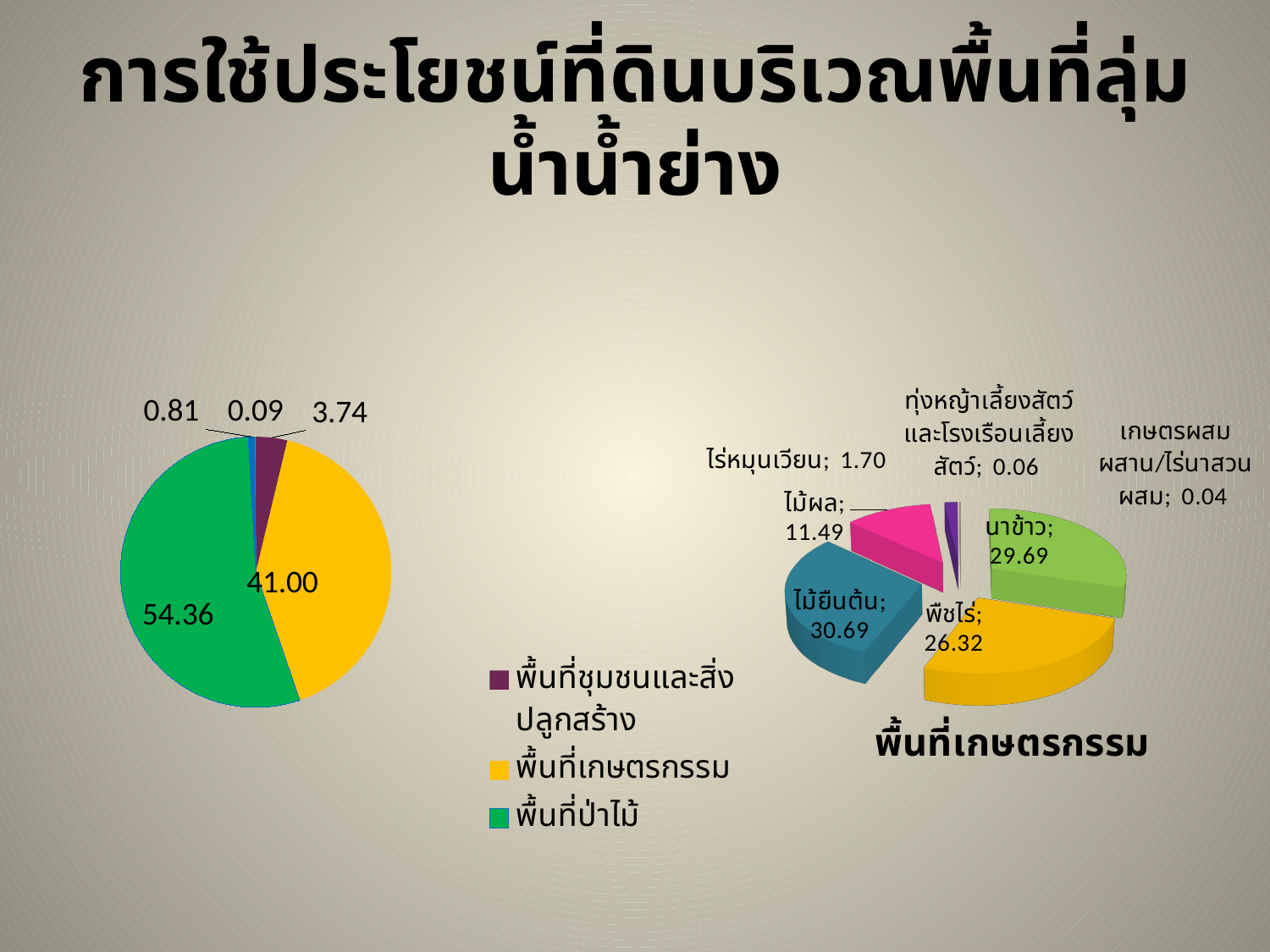
On the left pie chart, what is the value shown for พื้นที่ชุมชนและสิ่งปลูกสร้าง? 3.74 On the chart titled พื้นที่เกษตรกรรม, what is the difference between the values for ไม้ยืนต้น and ไม้ผล? 19.20 On the chart titled พื้นที่เกษตรกรรม, how many slices does the pie have? 7 On the chart titled พื้นที่เกษตรกรรม, which is larger, นาข้าว or พืชไร่? นาข้าว On the left pie chart, what is the value shown for พื้นที่เกษตรกรรม? 41.00 On the left pie chart, what is the difference between the values for พื้นที่ป่าไม้ and พื้นที่เกษตรกรรม? 13.36 On the chart titled พื้นที่เกษตรกรรม, which category has the smallest value? เกษตรผสมผสาน/ไร่นาสวนผสม On the chart titled พื้นที่เกษตรกรรม, what is the value shown for ไม้ยืนต้น? 30.69 On the left pie chart, what is the value shown for พื้นที่ป่าไม้? 54.36 On the left pie chart, which category has the largest slice? พื้นที่ป่าไม้ What kind of chart is the chart on the left of the slide? Pie chart On the chart titled พื้นที่เกษตรกรรม, what is the value shown for นาข้าว? 29.69